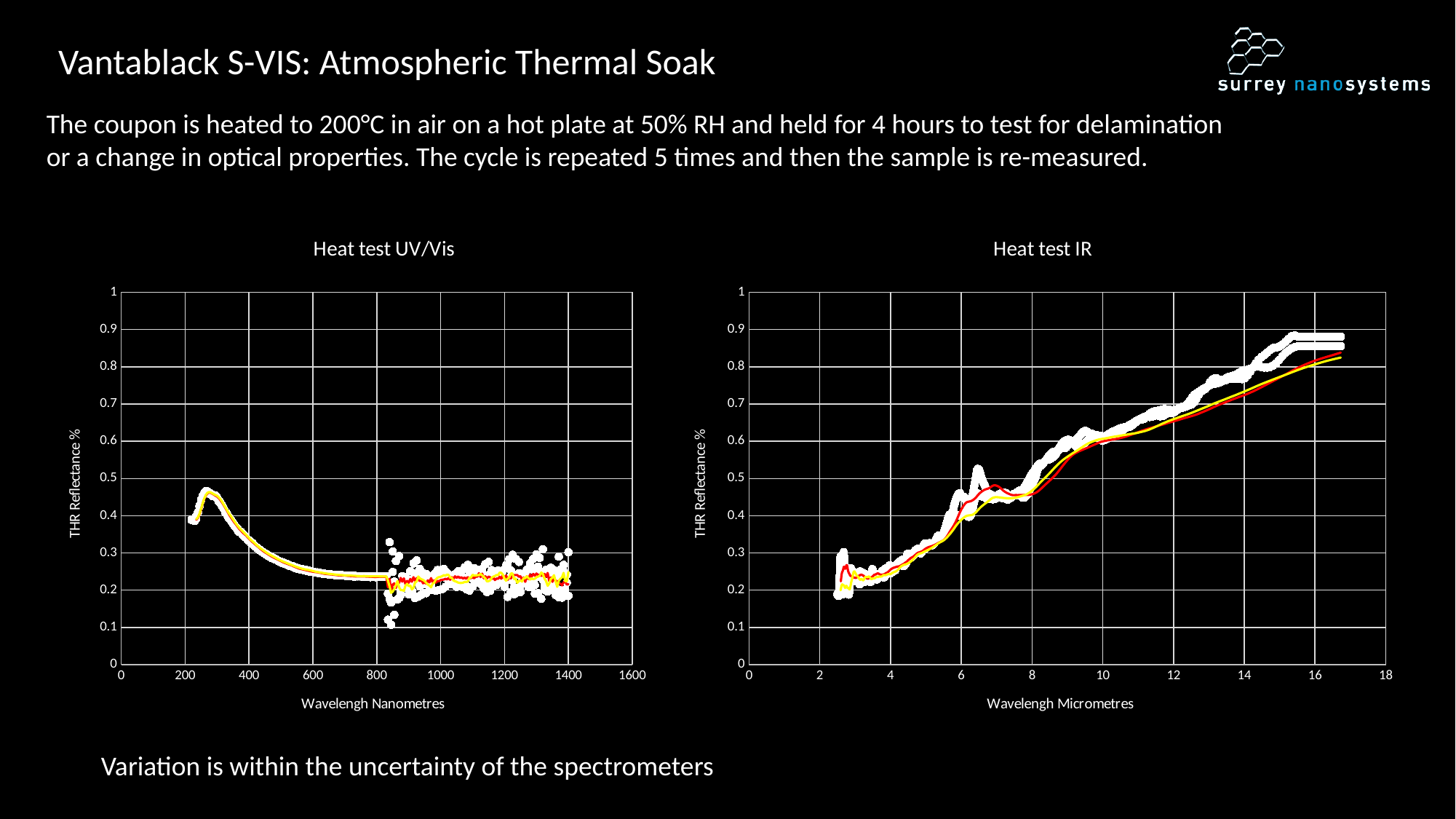
What is the y-axis label of the 'Heat test UV/Vis' chart? THR Reflectance % What kind of chart is the 'Heat test IR' chart? line chart What is the x-axis label of the 'Heat test IR' chart? Wavelengh Micrometres In the 'Heat test UV/Vis' chart, is the peak reflectance near 300 nanometres greater or less than 0.4? greater In the 'Heat test IR' chart, is the reflectance at 16 micrometres greater or less than 0.8? greater What kind of chart is the 'Heat test UV/Vis' chart? line chart In the 'Heat test IR' chart, which is larger: the reflectance at 6 micrometres or at 14 micrometres? 14 micrometres In the 'Heat test IR' chart, is the reflectance at 10 micrometres greater or less than 0.5? greater In the 'Heat test UV/Vis' chart, do the reflectance values rise or fall as wavelength increases from 300 to 600 nanometres? fall In the 'Heat test IR' chart, do the reflectance values generally rise or fall as wavelength increases from 4 to 16 micrometres? rise